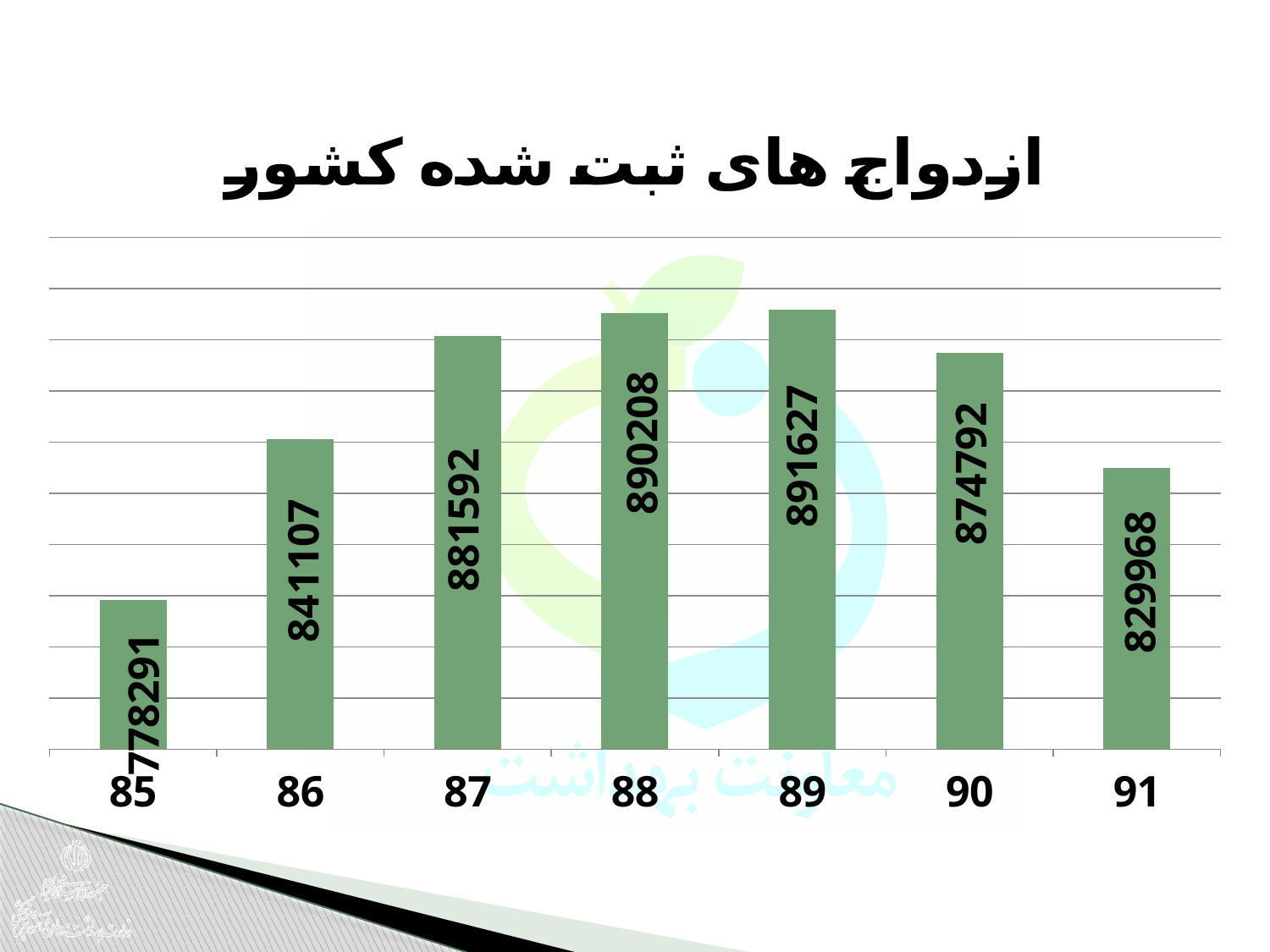
Do the values rise or fall from year 89 to year 91? fall What is the value for year 91? 829968 What is the difference between the values for year 89 and year 88? 1419 What is the difference between the values for year 86 and year 85? 62816 What type of chart is shown on the slide? bar chart What is the title of the chart? ازدواج های ثبت شده کشور Which year has the highest value? 89 Which year has the lowest value? 85 What is the value for year 88? 890208 How many years (categories) are shown on the x axis? 7 Which is larger, the value for year 87 or the value for year 90? 87 What is the value for year 85? 778291